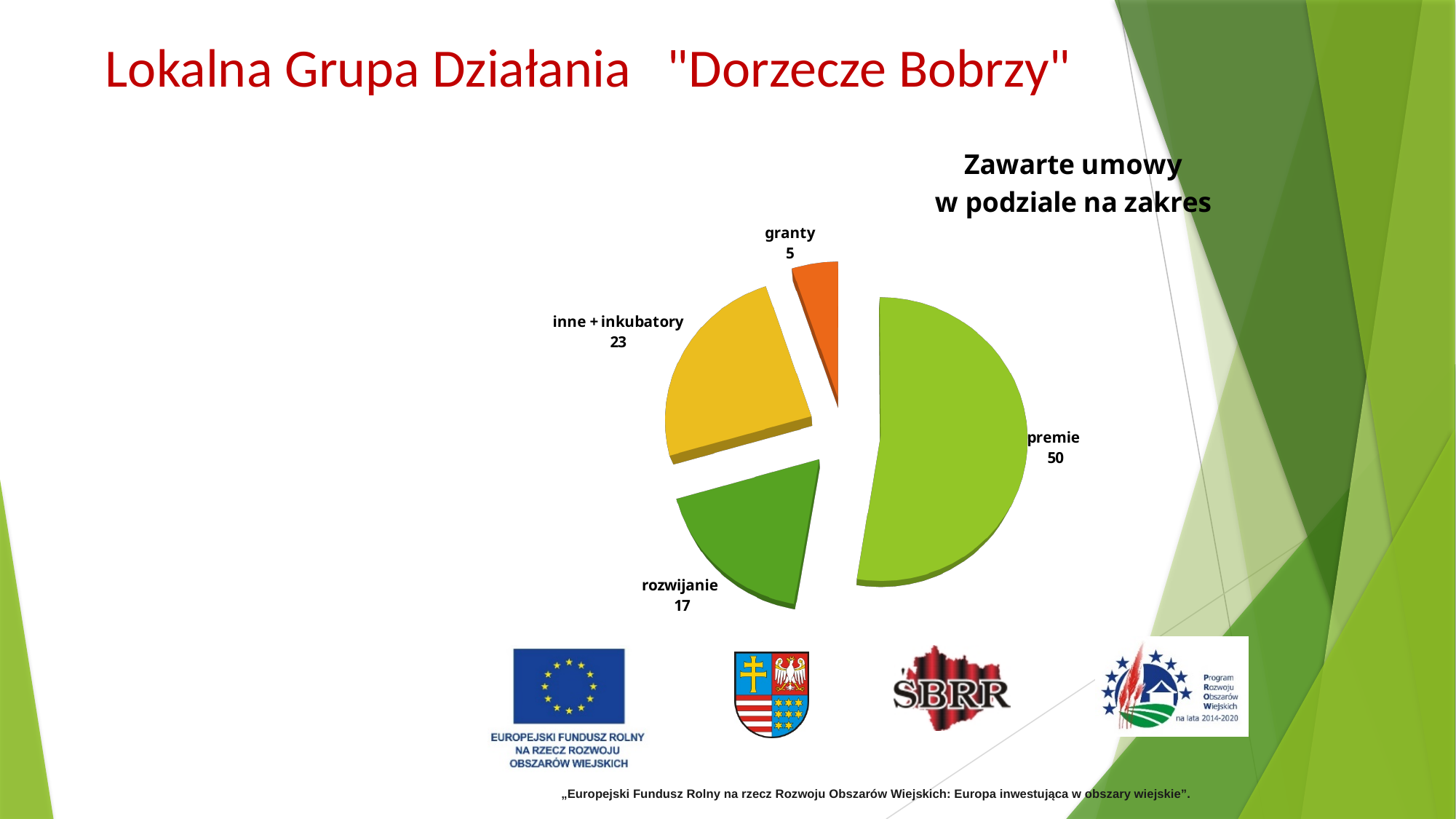
What is the difference between the values for premie and rozwijanie? 33 Which category has the largest slice? premie What is the value for granty? 5 Which is larger, inne + inkubatory or rozwijanie? inne + inkubatory What is the value for inne + inkubatory? 23 What is the value for rozwijanie? 17 What is the total of all slices in the pie chart? 95 How many slices does the pie chart have? 4 What kind of chart is shown on the slide? pie chart Which category has the smallest slice? granty What is the value for premie? 50 What is the title of the chart? Zawarte umowy w podziale na zakres